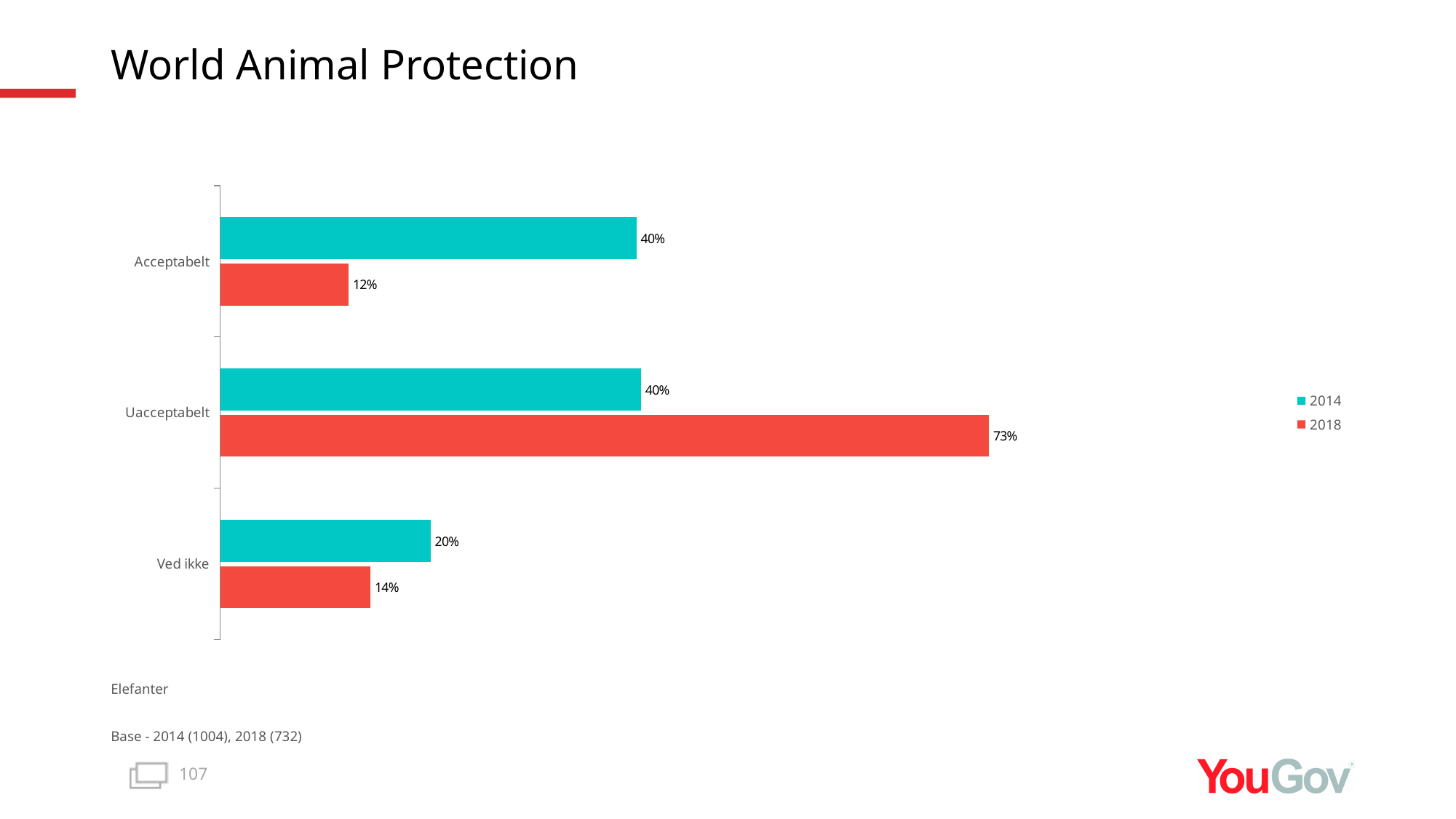
Which category has the lowest 2014 value? Ved ikke How many categories are shown on the chart? 3 What is the 2014 value for Acceptabelt? 40% What is the difference between the 2018 and 2014 values for Uacceptabelt? 33 percentage points What is the 2014 value for Ved ikke? 20% How many series does the legend list? 2 Which category has the lowest 2018 value? Acceptabelt Which is larger for Ved ikke: the 2014 value or the 2018 value? 2014 What is the 2018 value for Ved ikke? 14% Which category has the highest 2018 value? Uacceptabelt What is the 2018 value for Uacceptabelt? 73% What is the difference between the 2014 and 2018 values for Acceptabelt? 28 percentage points